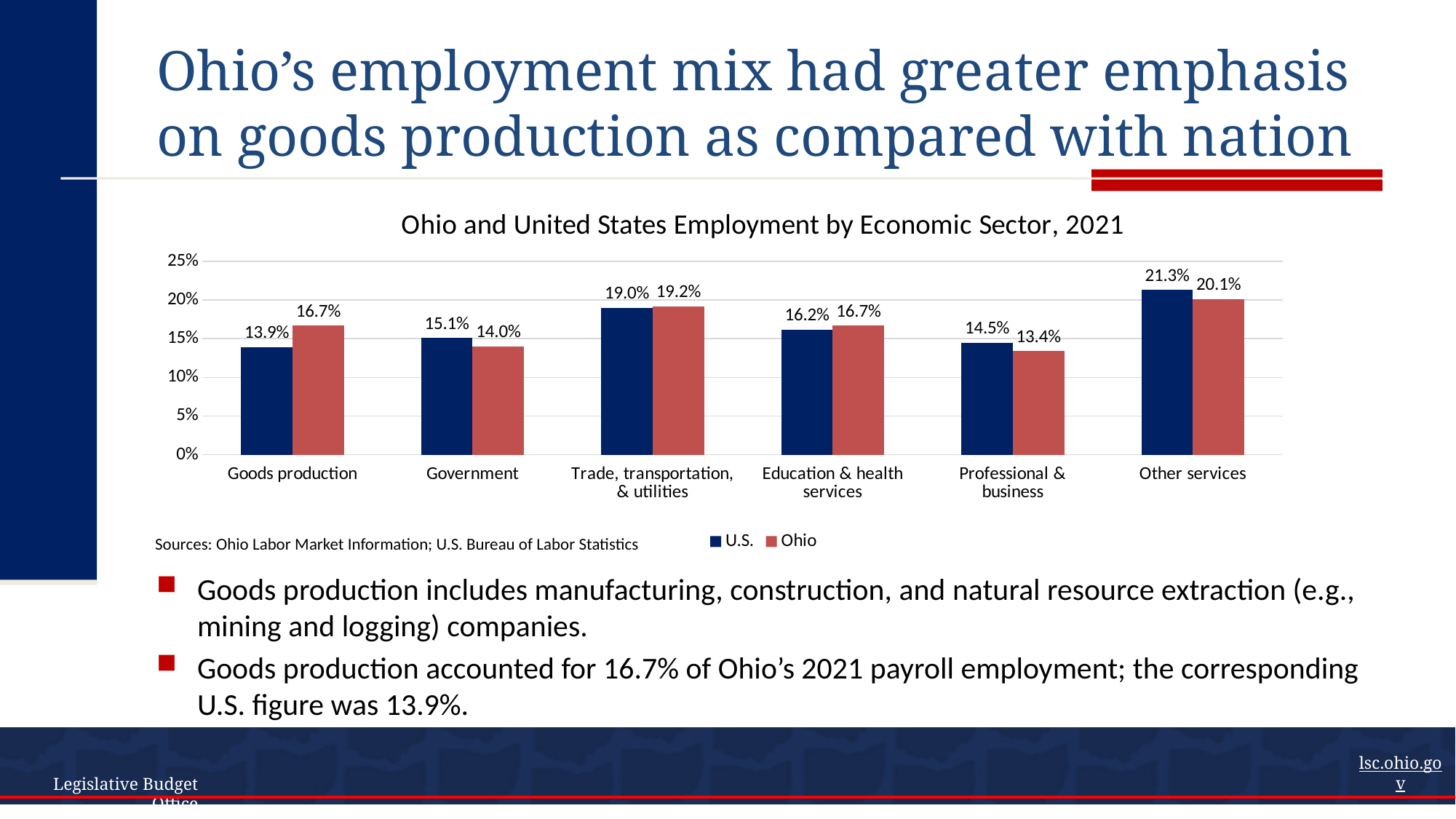
What is the difference between the Ohio and U.S. values for Goods production? 2.8% What kind of chart is shown on the slide? Bar chart Is the U.S. value for Other services greater or less than 20%? greater Which is larger for Government, the U.S. value or the Ohio value? U.S. Which sector has the highest U.S. value? Other services What is the U.S. value for Goods production? 13.9% How many series does the legend list? 2 What is the title of the chart? Ohio and United States Employment by Economic Sector, 2021 What is the Ohio value for Other services? 20.1% What is the Ohio value for Professional & business? 13.4% How many economic sectors are shown on the x axis? 6 Which sector has the lowest Ohio value? Professional & business